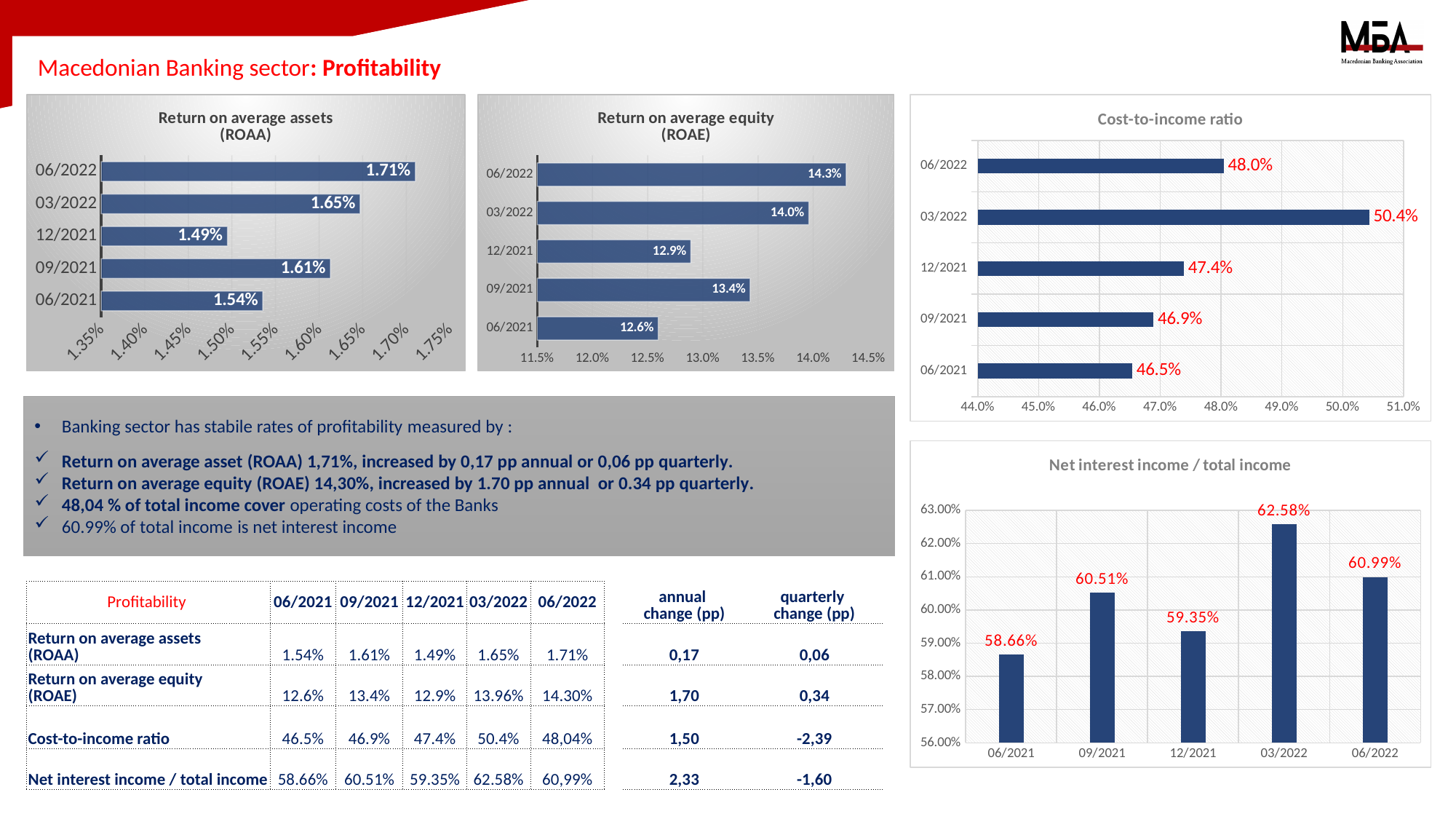
In the Return on average equity (ROAE) chart, what is the value for 09/2021? 13.4% In the Return on average assets (ROAA) chart, which period has the lowest value? 12/2021 In the Cost-to-income ratio chart, is the value for 06/2022 larger or smaller than the value for 12/2021? larger In the Cost-to-income ratio chart, what is the value for 03/2022? 50.4% In the Net interest income / total income chart, which period has the lowest value? 06/2021 In the Net interest income / total income chart, what is the value for 03/2022? 62.58% How many periods are shown in the Cost-to-income ratio chart? 5 In the Return on average assets (ROAA) chart, what is the value for 06/2022? 1.71% In the Return on average equity (ROAE) chart, what is the difference between the 06/2022 and 06/2021 values? 1.7 percentage points What type of chart is the Net interest income / total income chart? Bar chart In the Cost-to-income ratio chart, which period has the highest value? 03/2022 In the Return on average equity (ROAE) chart, which period has the highest value? 06/2022